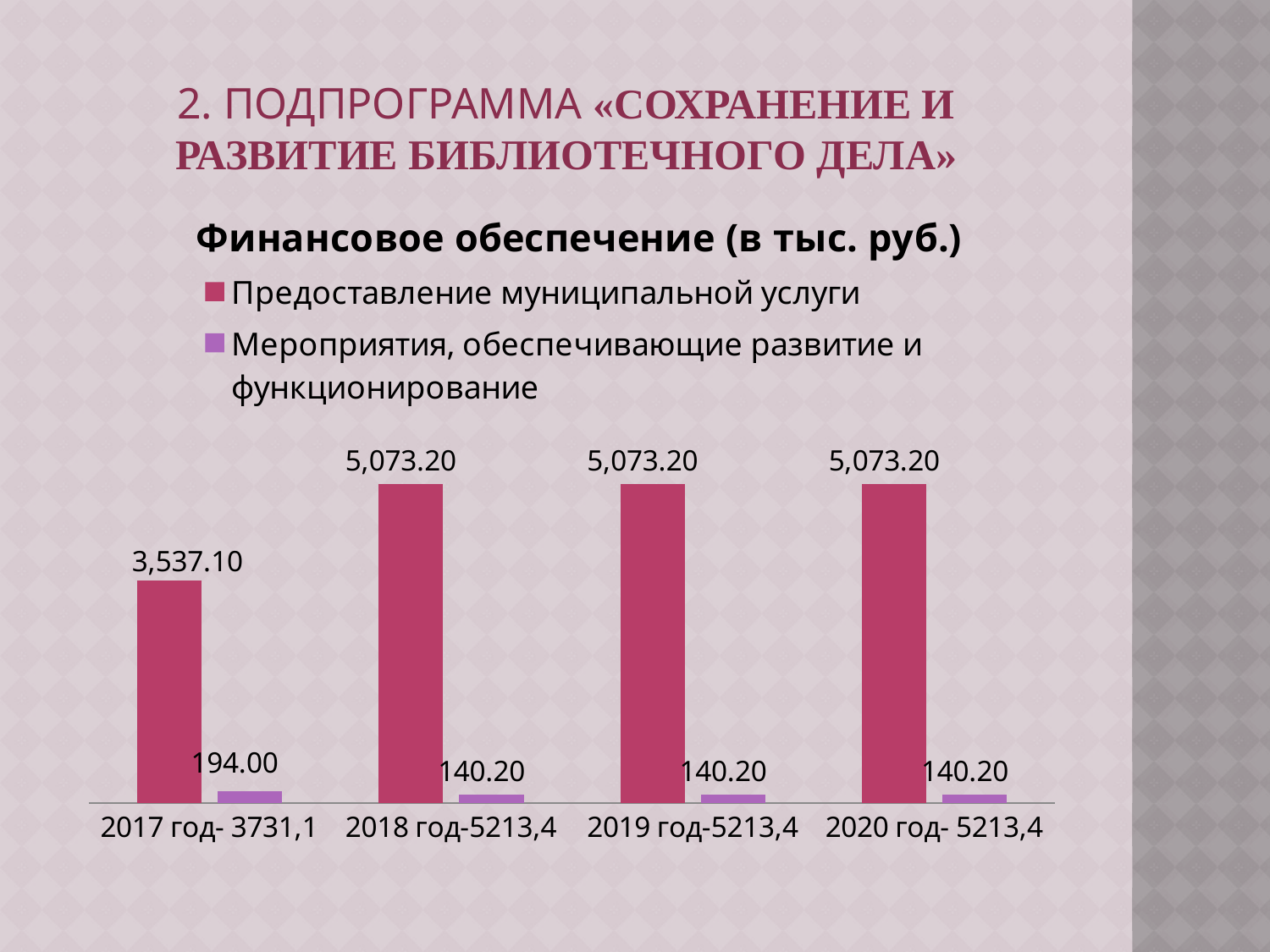
What is the value for "Мероприятия, обеспечивающие развитие и функционирование" in the category "2017 год- 3731,1"? 194.00 Which category has the lowest value for "Предоставление муниципальной услуги"? 2017 год- 3731,1 What is the difference between the "Мероприятия, обеспечивающие развитие и функционирование" values for "2017 год- 3731,1" and "2018 год-5213,4"? 53.80 How many categories are shown on the x axis of the chart? 4 How many series does the chart legend list? 2 What is the value for "Предоставление муниципальной услуги" in the category "2017 год- 3731,1"? 3,537.10 What is the value for "Предоставление муниципальной услуги" in the category "2019 год-5213,4"? 5,073.20 What type of chart is shown on the slide? Bar chart Which category has the highest value for "Мероприятия, обеспечивающие развитие и функционирование"? 2017 год- 3731,1 What is the value for "Мероприятия, обеспечивающие развитие и функционирование" in the category "2020 год- 5213,4"? 140.20 Which is larger in the category "2019 год-5213,4": "Предоставление муниципальной услуги" or "Мероприятия, обеспечивающие развитие и функционирование"? Предоставление муниципальной услуги What is the difference between the "Предоставление муниципальной услуги" values for "2018 год-5213,4" and "2017 год- 3731,1"? 1,536.10